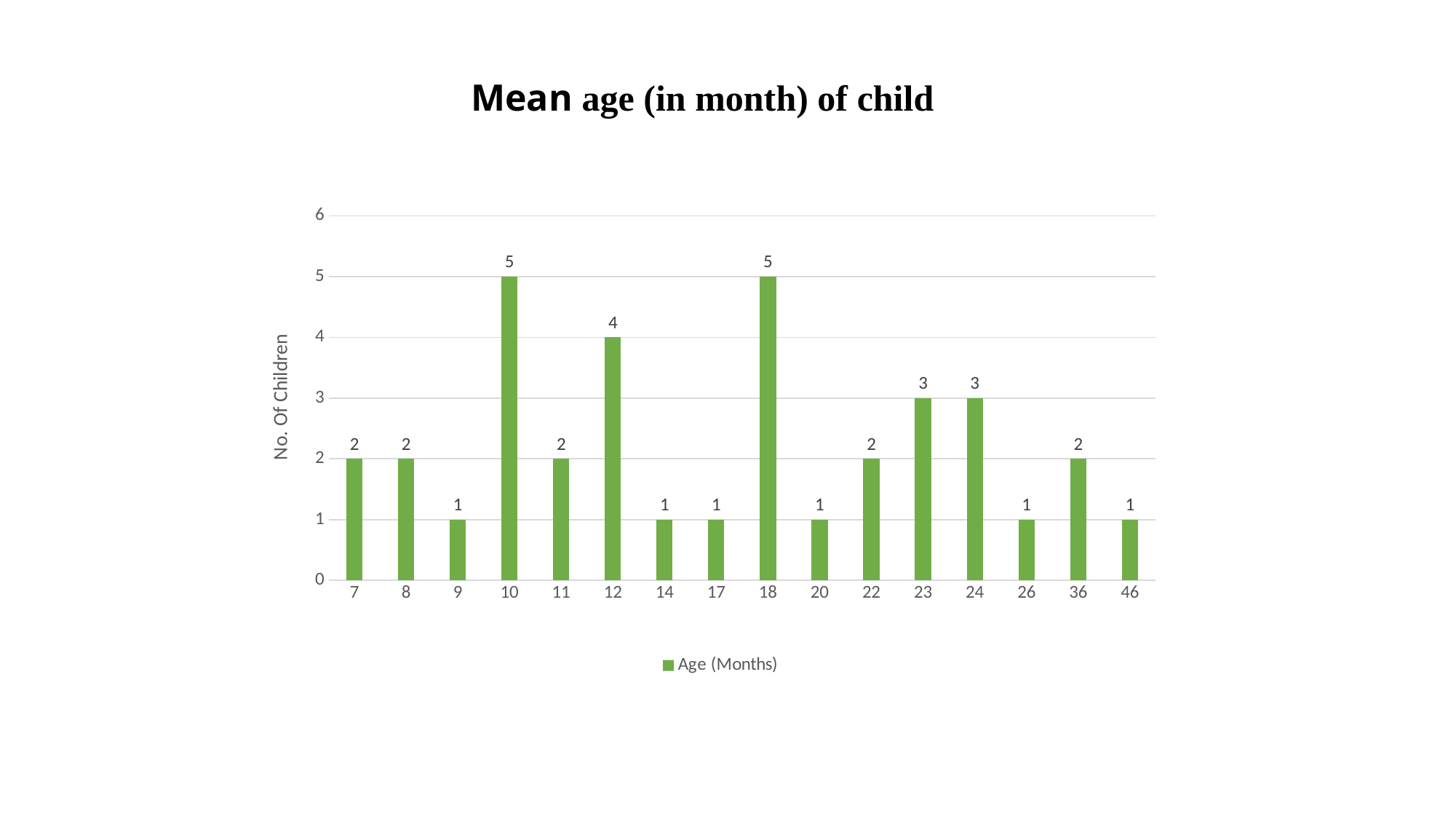
Which has more children: age 9 months or age 8 months? 8 months What is the number of children for age 23 months? 3 How many series does the legend list? 1 What is the difference between the number of children at age 10 months and at age 11 months? 3 Which has more children: age 18 months or age 22 months? 18 months What is the number of children for age 46 months? 1 What kind of chart is shown on the slide? Bar chart How many age categories are shown on the x axis? 16 What is the number of children for age 36 months? 2 What is the label of the y axis? No. Of Children What is the number of children for age 12 months? 4 What is the difference between the number of children at age 12 months and at age 24 months? 1